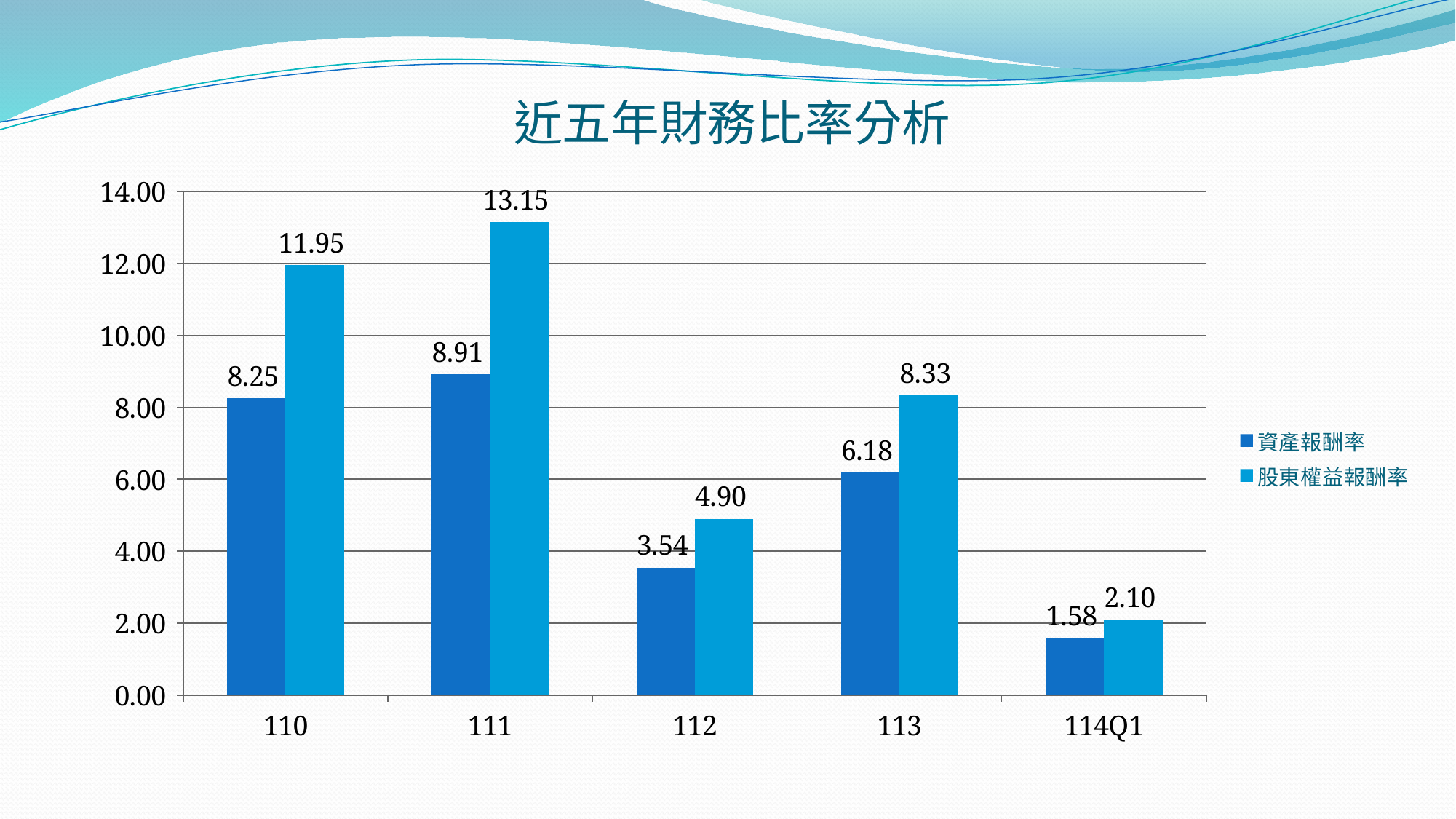
What is the value of 股東權益報酬率 for 111? 13.15 What is the value of 股東權益報酬率 for 114Q1? 2.10 Which category has the lowest 資產報酬率? 114Q1 What kind of chart is shown on the slide? bar chart Which is larger: 資產報酬率 for 111 or 資產報酬率 for 113? 111 Is the value of 股東權益報酬率 for 112 greater or less than 6.00? less What is the title of the chart? 近五年財務比率分析 Which category has the highest 股東權益報酬率? 111 What is the value of 資產報酬率 for 110? 8.25 How many series does the legend list? 2 How many categories are shown on the x axis? 5 What is the difference between 股東權益報酬率 and 資產報酬率 for 113? 2.15